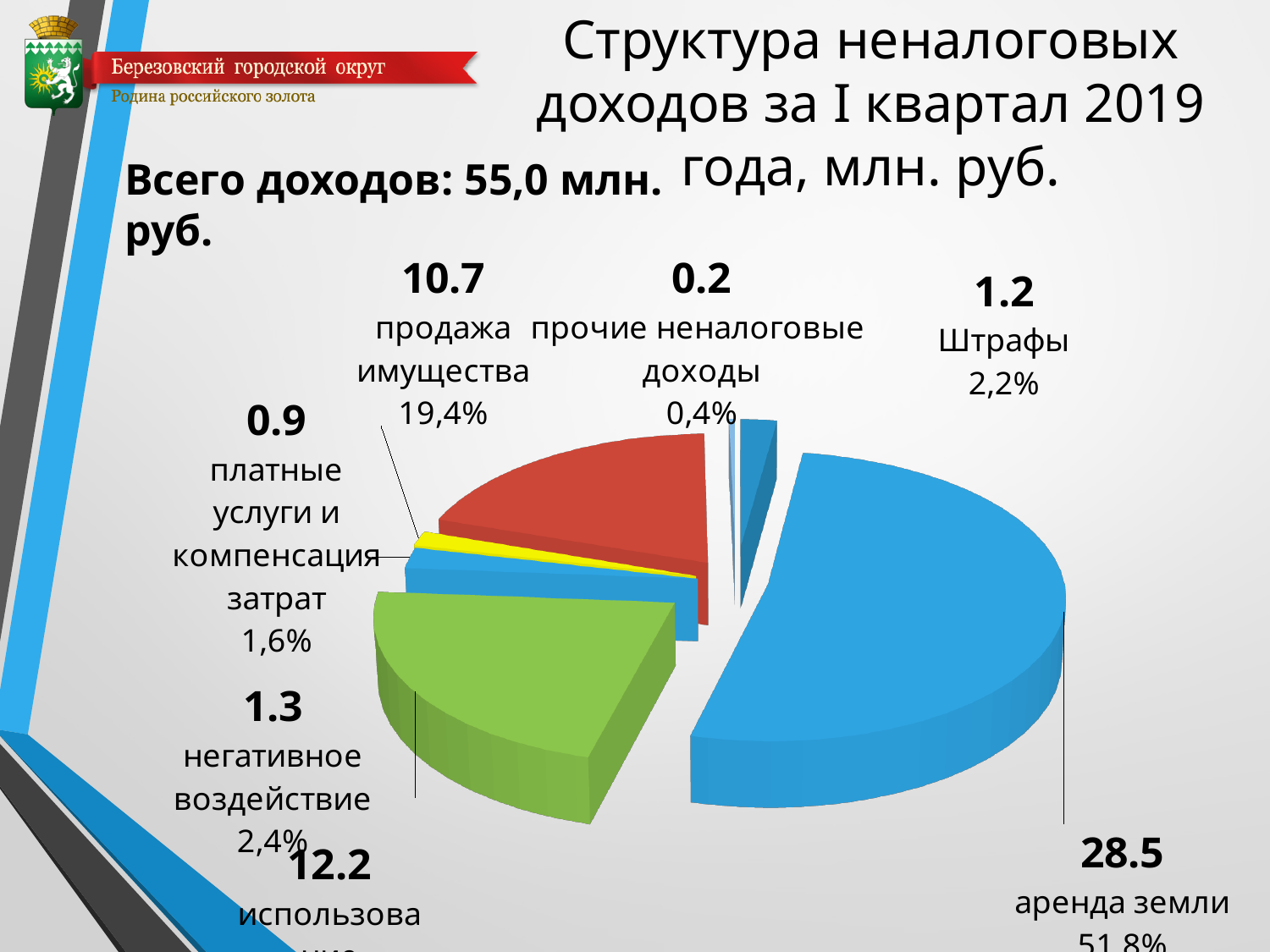
What share of the pie does негативное воздействие take? 2,4% Which category has the smallest slice? прочие неналоговые доходы What is the difference between the values for аренда земли and продажа имущества? 17.8 What is the value for аренда земли? 28.5 What kind of chart is shown on the slide? pie chart What is the value for продажа имущества? 10.7 What is the value for прочие неналоговые доходы? 0.2 Which category has the largest slice? аренда земли What share of the pie does аренда земли take? 51,8% What is the title of the chart? Структура неналоговых доходов за I квартал 2019 года, млн. руб. Which is larger, the value for Штрафы or the value for платные услуги и компенсация затрат? Штрафы What is the value for Штрафы? 1.2